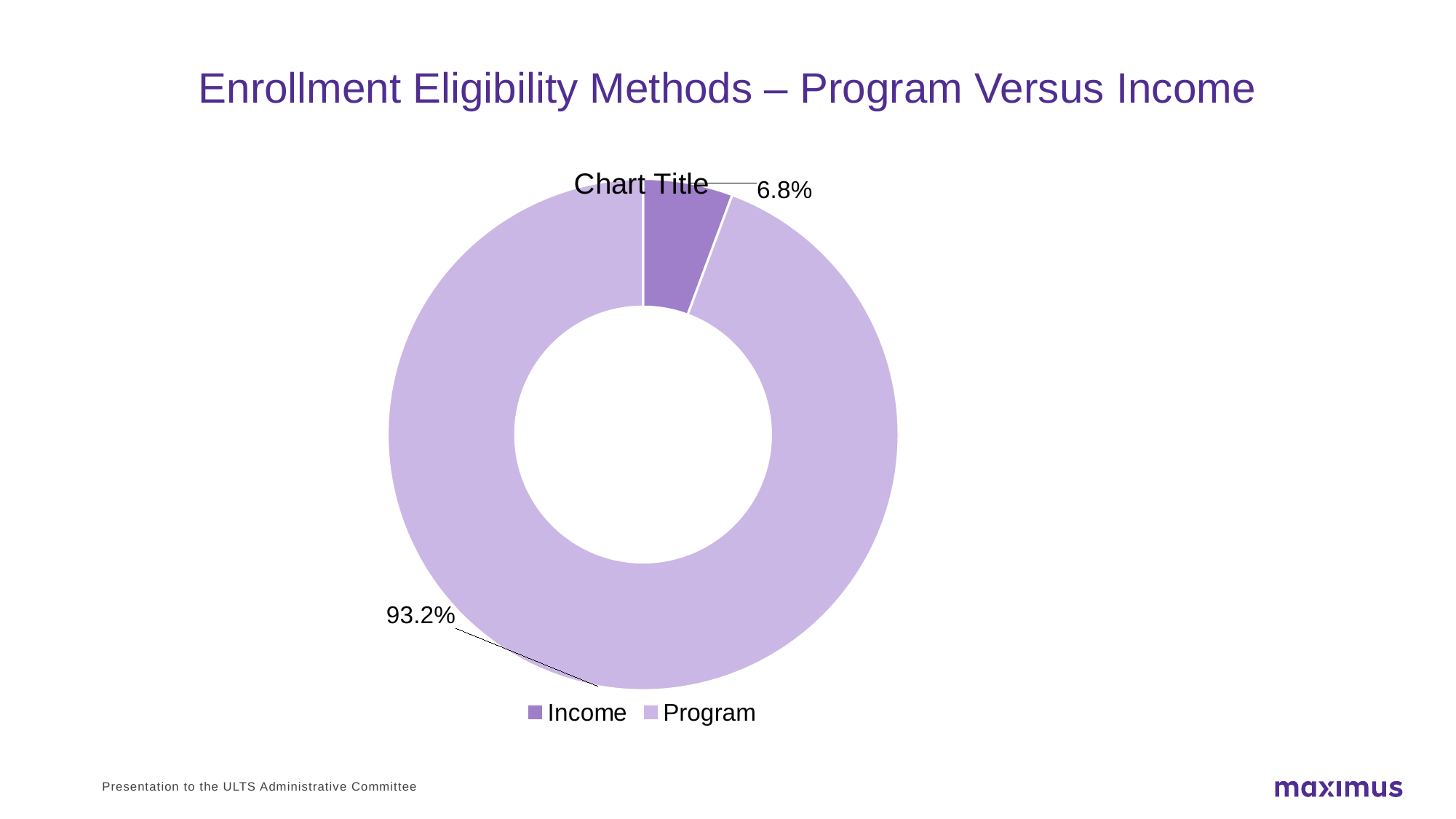
What share of the doughnut chart does Income account for? 6.8% Which category has the largest share of the chart? Program What is the title printed above the chart? Chart Title Which category has the smallest share of the chart? Income How many entries does the chart legend list? 2 What share of the doughnut chart does Program account for? 93.2% Which is larger, the Income share or the Program share? Program What is the difference in percentage points between the Program share and the Income share? 86.4 Which category is shown in the darker purple colour? Income What kind of chart is shown on the slide? Doughnut chart How many categories are shown in the chart? 2